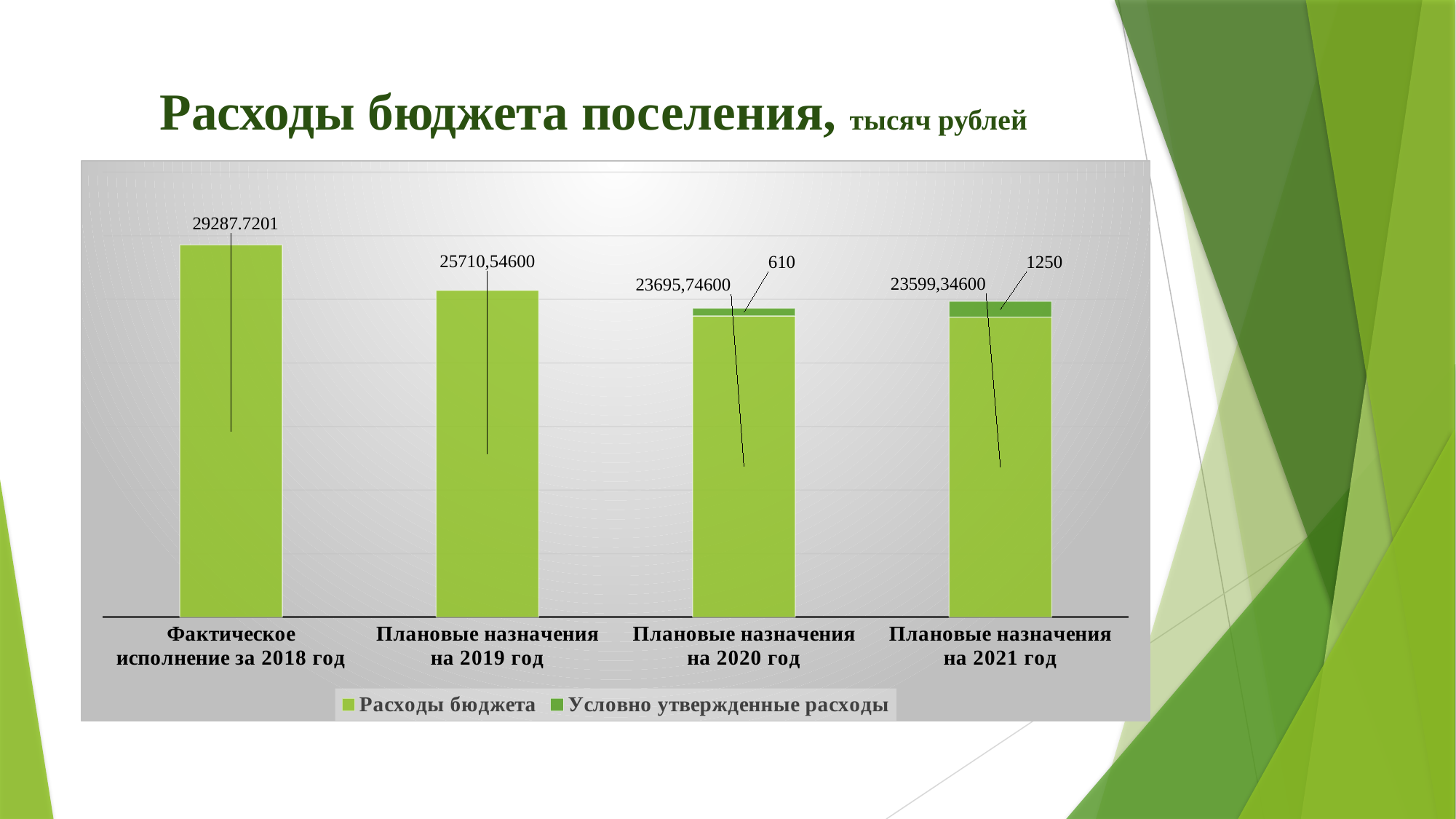
What is the value of Расходы бюджета for Плановые назначения на 2019 год? 25710,54600 Which category has the lowest value of Расходы бюджета? Плановые назначения на 2021 год What is the value of Расходы бюджета for Фактическое исполнение за 2018 год? 29287.7201 What is the value of Условно утвержденные расходы for Плановые назначения на 2021 год? 1250 How many categories are shown on the x axis? 4 What type of chart is shown on the slide? bar chart What is the value of Условно утвержденные расходы for Плановые назначения на 2020 год? 610 What is the difference between Условно утвержденные расходы for 2021 and for 2020? 640 Which category has the highest value of Расходы бюджета? Фактическое исполнение за 2018 год Which is larger: Расходы бюджета for Плановые назначения на 2019 год or for Плановые назначения на 2020 год? Плановые назначения на 2019 год How many series does the legend list? 2 What is the value of Расходы бюджета for Плановые назначения на 2020 год? 23695,74600